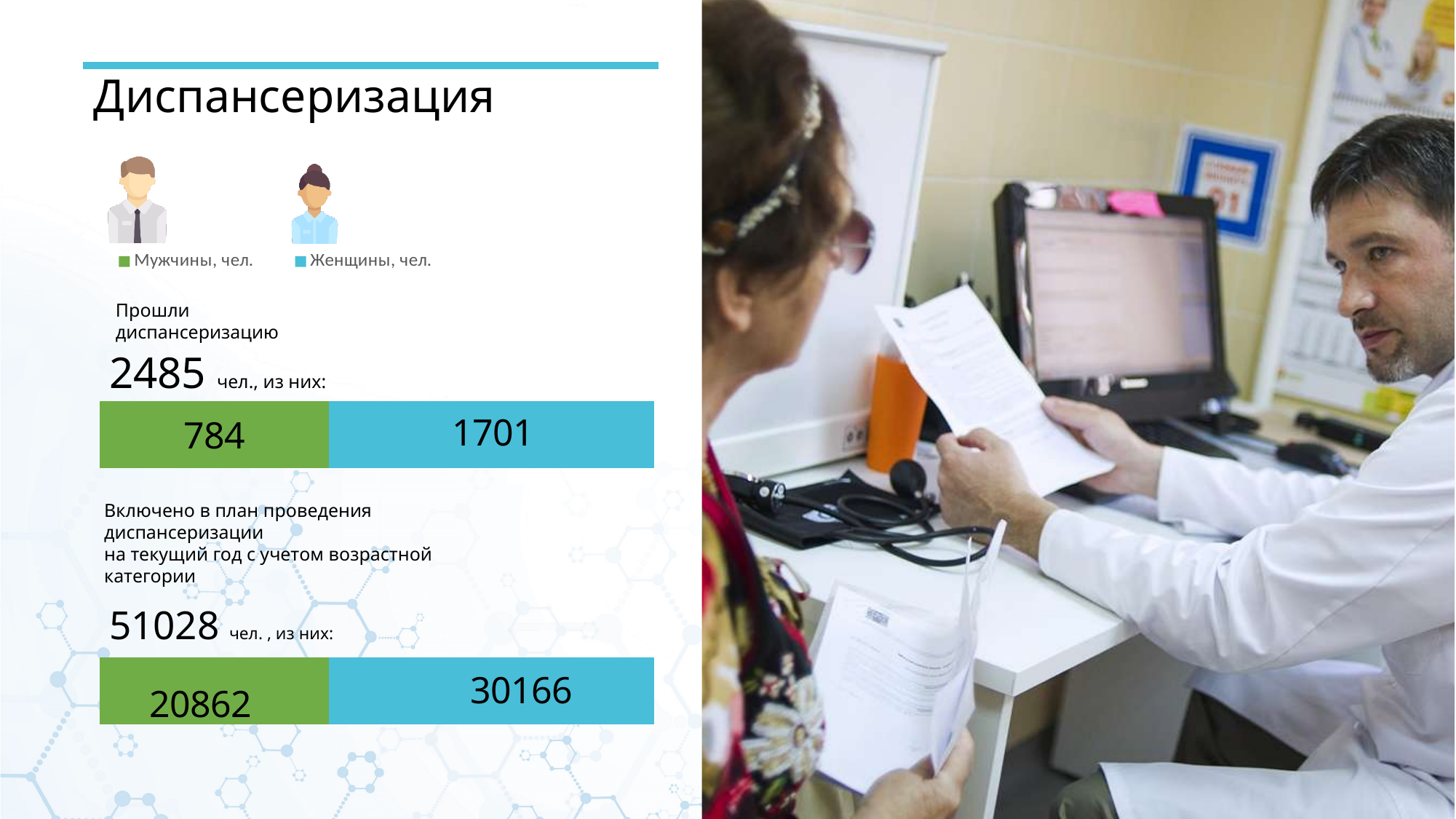
In the upper bar (Прошли диспансеризацию), which is larger: Мужчины or Женщины? Женщины Which colour represents Мужчины, чел. in the legend? Green What kind of chart is used to show the Мужчины and Женщины values? Stacked bar chart In the upper bar (Прошли диспансеризацию), what is the value for Мужчины, чел.? 784 What is the total of the lower stacked bar (Включено в план проведения диспансеризации)? 51028 In the upper bar (Прошли диспансеризацию), what is the value for Женщины, чел.? 1701 What is the total of the upper stacked bar (Прошли диспансеризацию)? 2485 How many series does the legend list? 2 In the lower bar (Включено в план проведения диспансеризации), what is the value for Мужчины, чел.? 20862 In the lower bar (Включено в план проведения диспансеризации), what is the value for Женщины, чел.? 30166 In the lower bar (Включено в план проведения диспансеризации), what is the difference between Женщины and Мужчины? 9304 In the upper bar (Прошли диспансеризацию), what is the difference between Женщины and Мужчины? 917